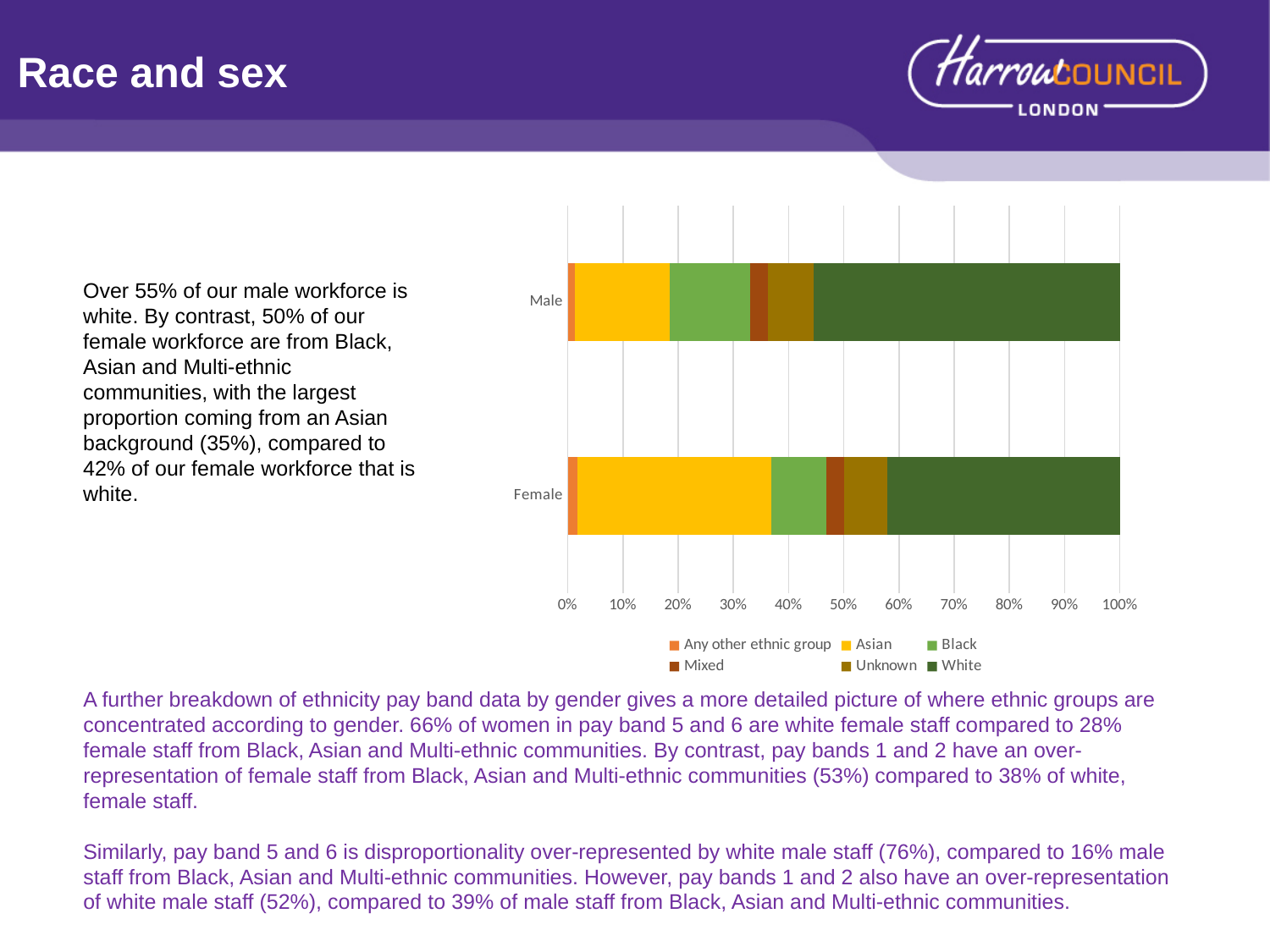
What kind of chart is shown on the slide? Stacked bar chart Which series is shown in dark green in the legend? White Is the Asian share of the Female bar greater or less than 30%? greater How many series does the legend list? 6 Which bar has the larger Black share, Male or Female? Male Which two categories are plotted on the chart? Male and Female How many categories (bars) does the chart show? 2 Which bar has the larger Asian share, Male or Female? Female Is the White share of the Female bar greater or less than 50%? less Which bar has the larger White share, Male or Female? Male Is the Asian share of the Male bar greater or less than 20%? less